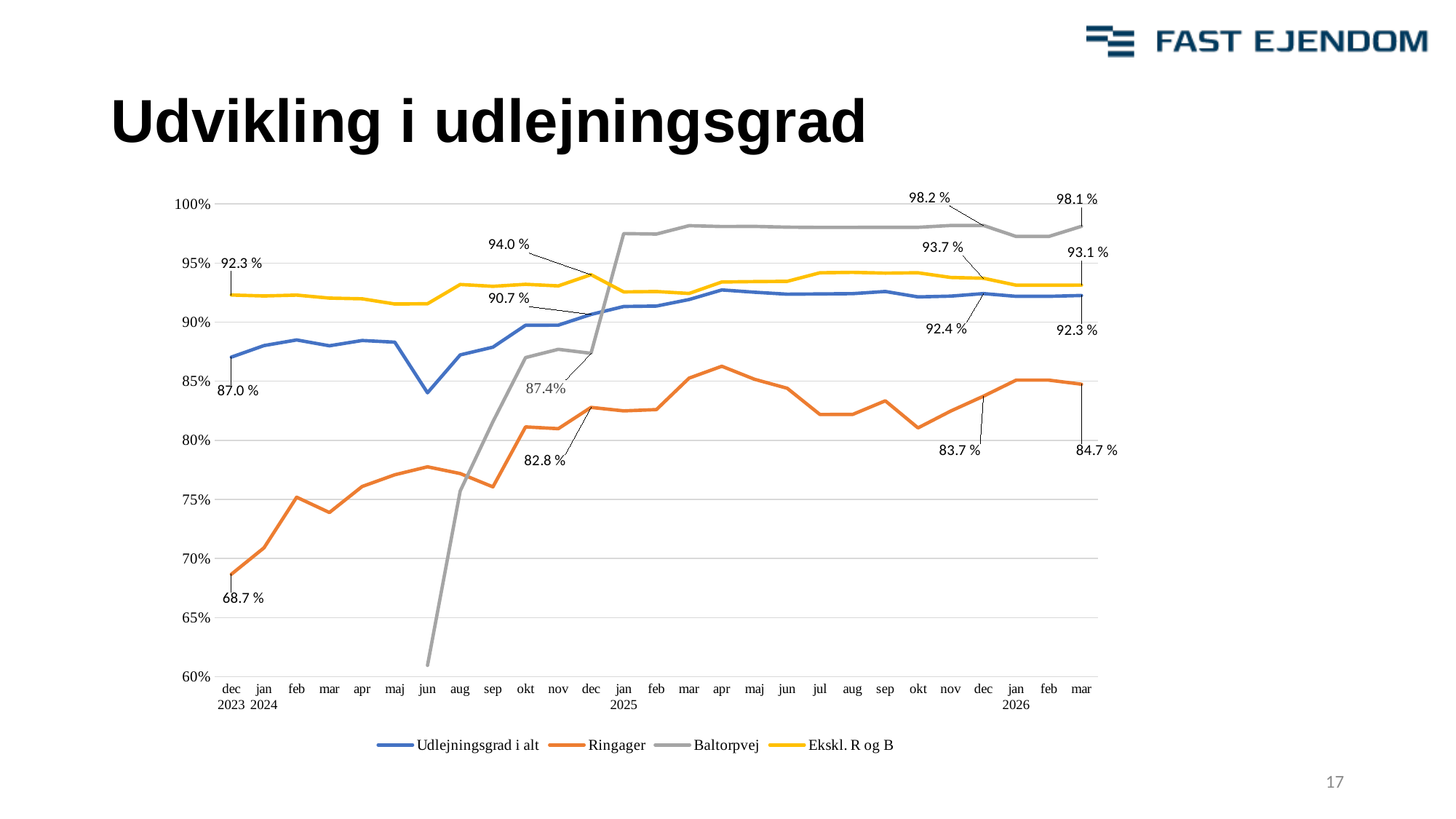
In mar 2026, which is larger: Ekskl. R og B or Udlejningsgrad i alt? Ekskl. R og B What is the value for Udlejningsgrad i alt in dec 2024? 90.7 % Which series has the highest value in mar 2026? Baltorpvej What is the difference between Baltorpvej in dec 2025 and dec 2024? 10.8 percentage points How many series does the legend list? 4 What is the value for Ringager in dec 2023? 68.7 % Which series has the lowest value in dec 2023? Ringager What is the value for Baltorpvej in mar 2026? 98.1 % What is the value for Ekskl. R og B in dec 2025? 93.7 % By how many percentage points did Ringager rise from dec 2023 to mar 2026? 16.0 percentage points Is the value for Baltorpvej in jun 2024 greater or less than 65%? less What kind of chart is shown on the slide? Line chart